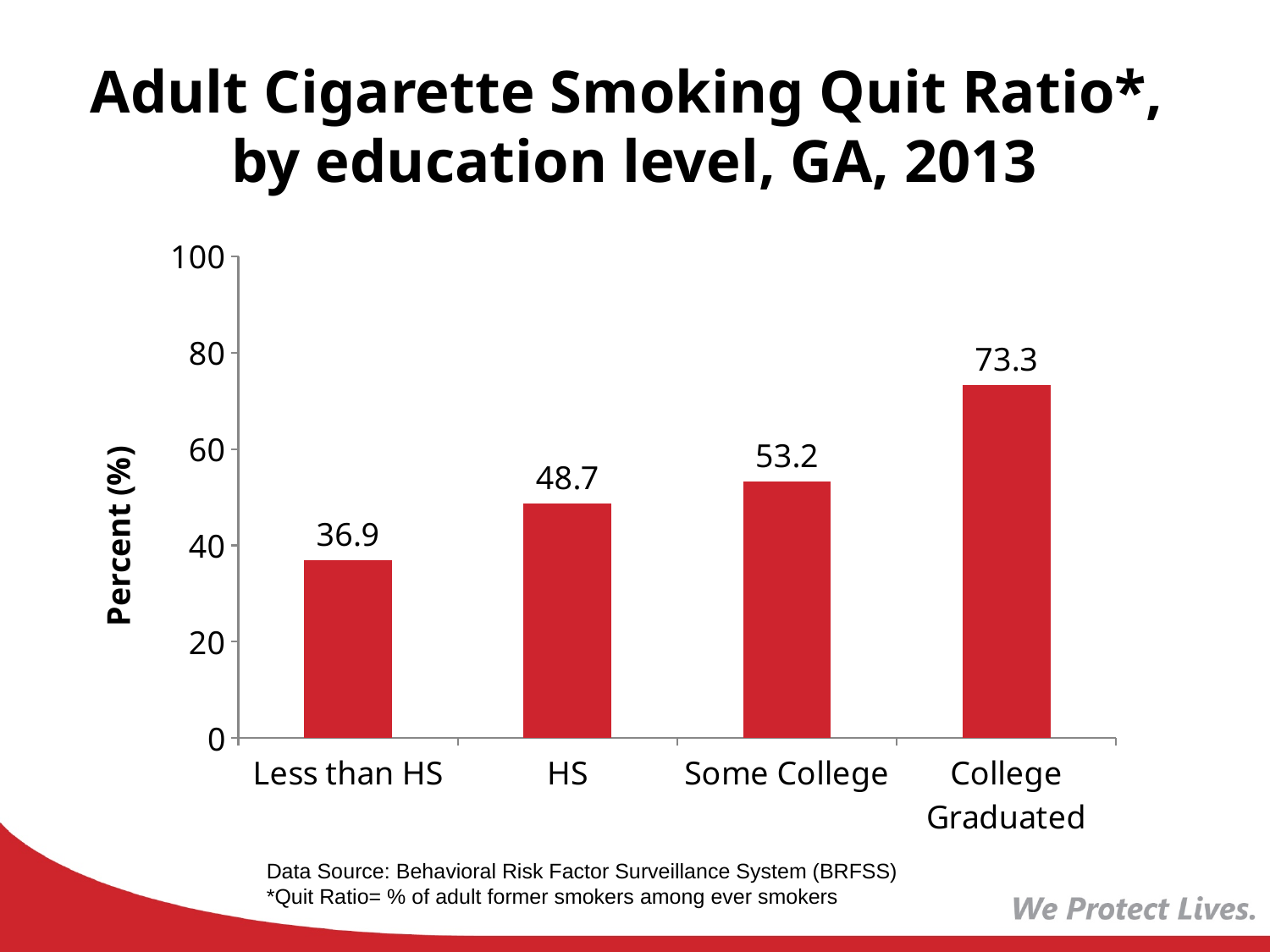
Which has a higher quit ratio, HS or Some College? Some College How many education levels are shown in the chart? 4 What is the difference in quit ratio between Some College and HS? 4.5 Which education level has the highest quit ratio? College Graduated What is the quit ratio for the HS education level? 48.7 Do the quit ratios rise or fall as education level increases from left to right? Rise What type of chart is shown on the slide? Bar chart What is the difference in quit ratio between College Graduated and Less than HS? 36.4 What is the quit ratio for adults with less than a high school education? 36.9 What is the quit ratio for College Graduated? 73.3 Which education level has the lowest quit ratio? Less than HS What is the quit ratio for the Some College category? 53.2